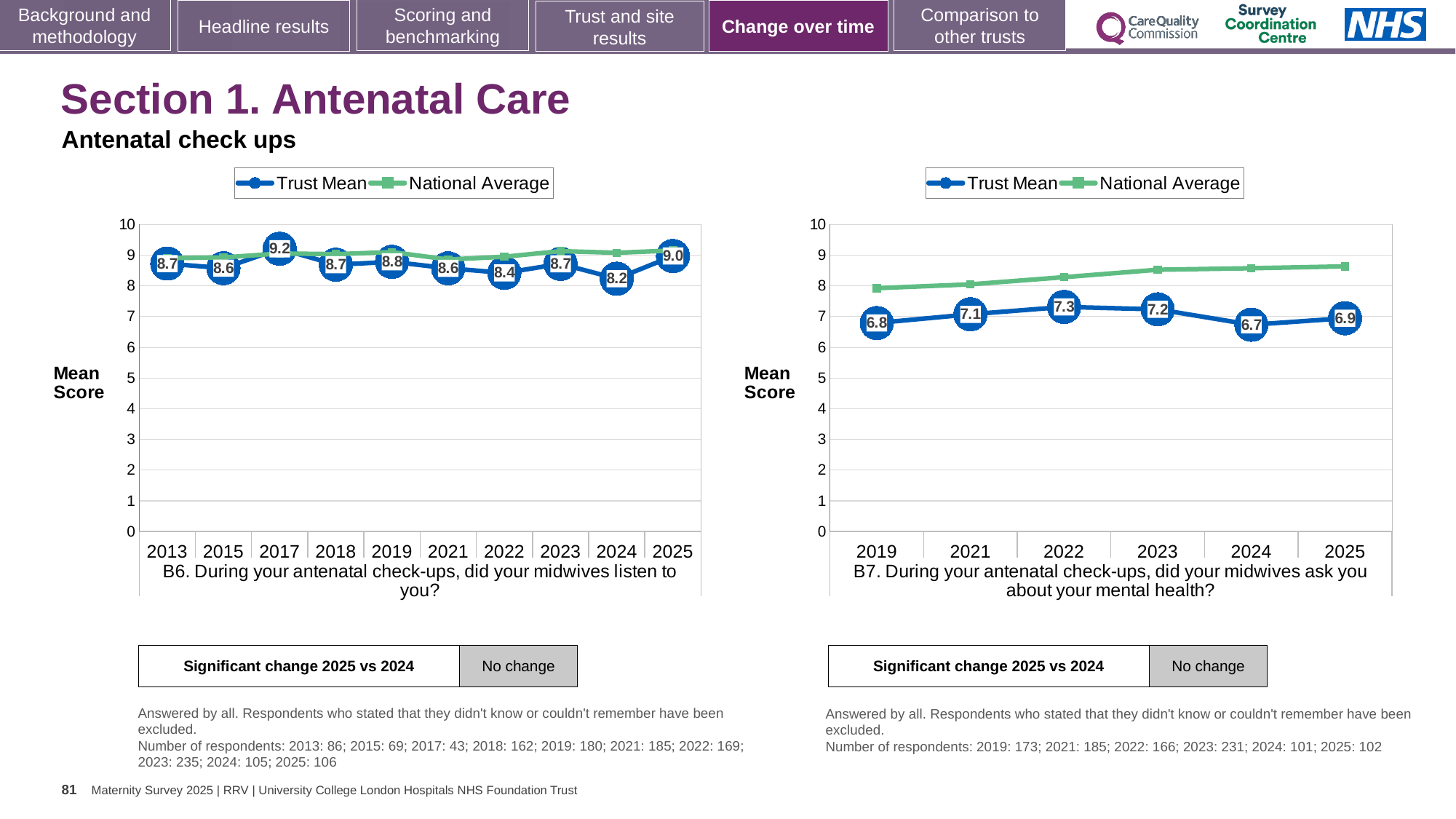
What kind of chart is the B7 chart (right)? Line chart In the B6 chart (left), what is the difference between the Trust Mean in 2025 and in 2024? 0.8 In the B6 chart (left), what is the Trust Mean for 2017? 9.2 In the B6 chart (left), how many years are plotted on the x axis? 10 In the B7 chart (right), is the National Average for 2023 greater or less than 8? greater In the B7 chart (right), is the Trust Mean higher in 2021 or in 2025? 2021 In the B7 chart (right), what is the Trust Mean for 2022? 7.3 In the B6 chart (left), what is the Trust Mean for 2024? 8.2 In the B6 chart (left), which year has the highest Trust Mean? 2017 In the B7 chart (right), which year has the lowest Trust Mean? 2024 In the B7 chart (right), how many series does the legend list? 2 In the B6 chart (left), which year has the lowest Trust Mean? 2024